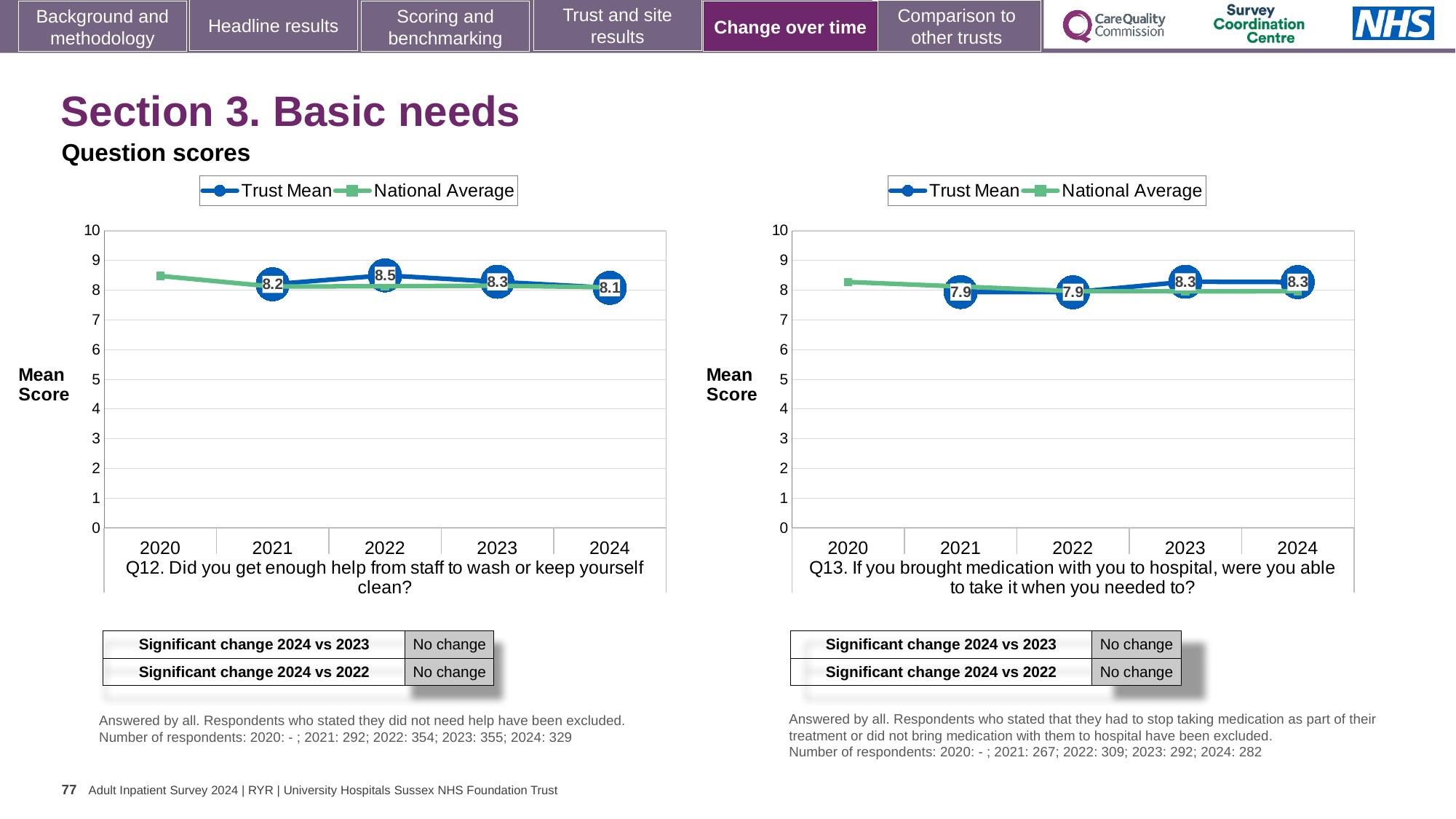
What type of chart is used for Q12 (left)? Line chart In the Q12 chart (left), which year has the lowest labelled Trust Mean score? 2024 In the Q13 chart (right), does the Trust Mean score rise or fall from 2022 to 2023? Rise In the Q12 chart (left), is the Trust Mean score higher in 2021 or 2022? 2022 In the Q13 chart (right), what is the Trust Mean score for 2024? 8.3 How many years are shown on the x axis of the Q13 chart (right)? 5 In the Q12 chart (left), which year has the highest Trust Mean score? 2022 In the Q13 chart (right), what is the difference between the Trust Mean scores for 2023 and 2021? 0.4 In the Q13 chart (right), is the National Average value for 2020 greater or less than 8? greater In the Q12 chart (left), what is the Trust Mean score for 2022? 8.5 In the Q12 chart (left), what is the difference between the Trust Mean scores for 2022 and 2024? 0.4 How many series does the legend of the Q12 chart (left) list? 2